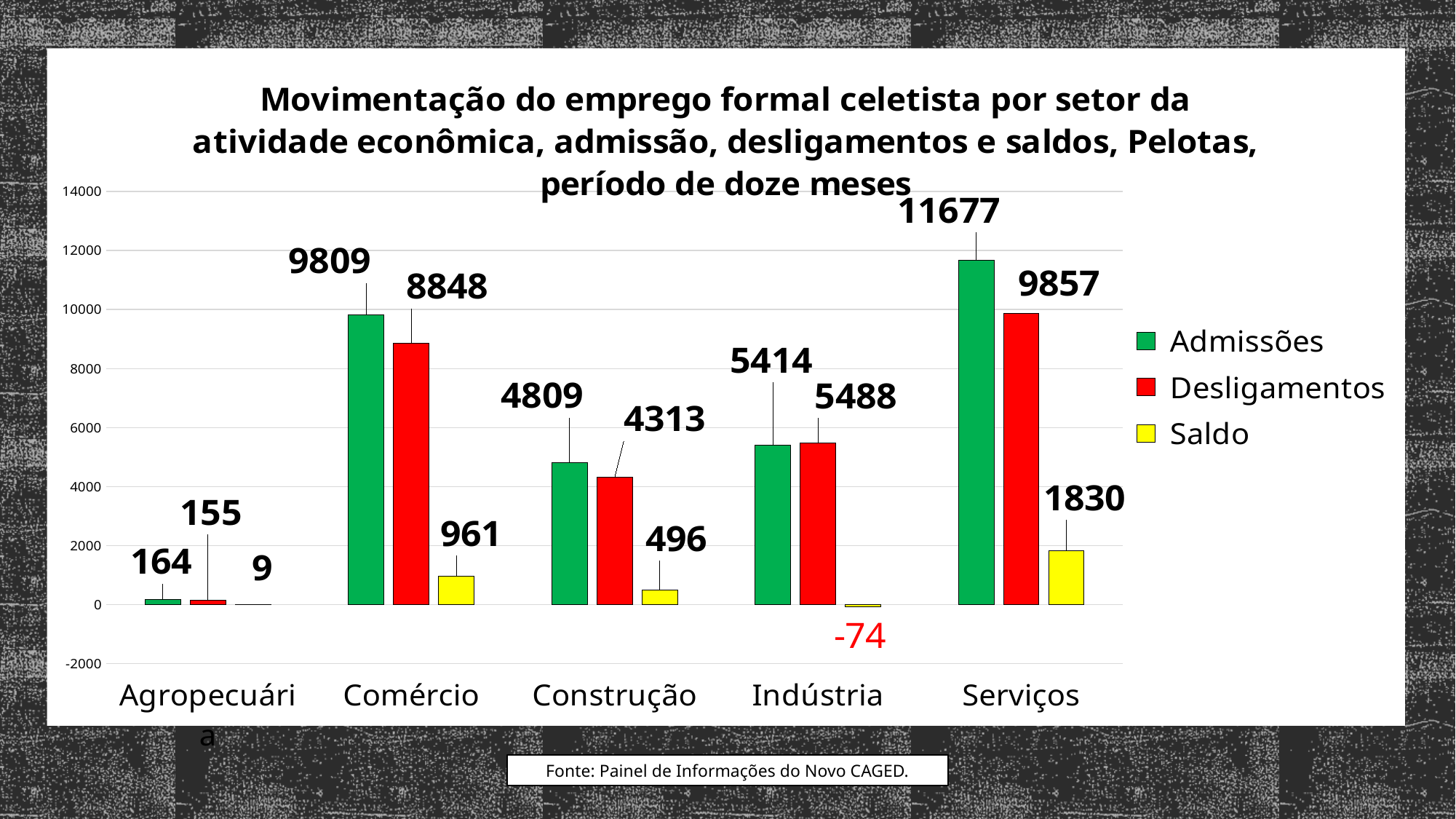
What is the Saldo value for Indústria? -74 How many sectors are shown on the x axis? 5 What kind of chart is shown on the slide? Bar chart Is the Admissões value for Construção greater or less than 4000? greater How many series does the legend list? 3 What is the difference between Admissões and Desligamentos for Comércio? 961 Which sector has the lowest Saldo value? Indústria What is the value of Desligamentos for Comércio? 8848 Which sector has the highest Admissões value? Serviços What is the value of Admissões for Serviços? 11677 What colour represents the Saldo series? Yellow Which is larger for Indústria, Admissões or Desligamentos? Desligamentos